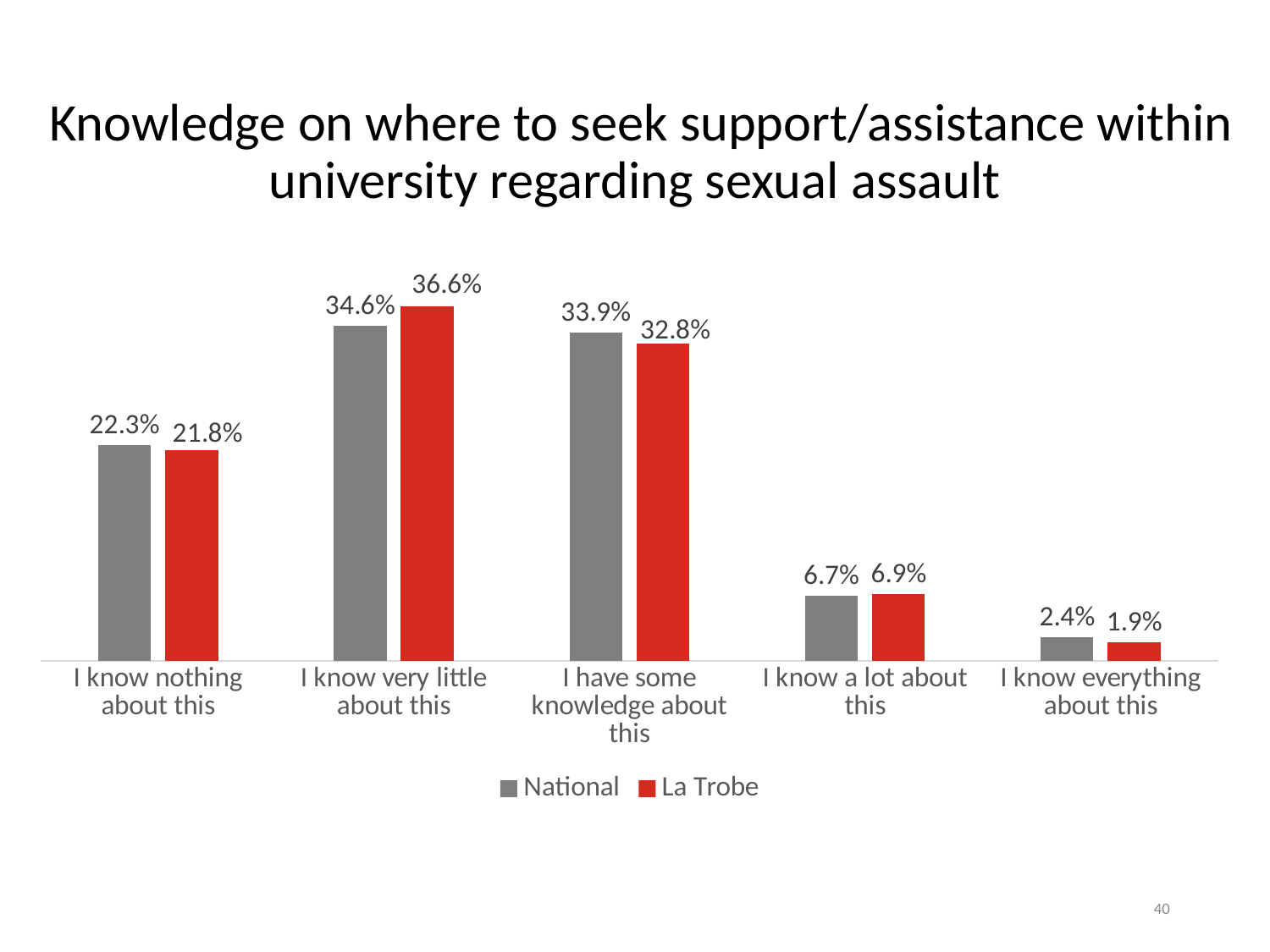
What is the National value for "I know nothing about this"? 22.3% What is the difference between the La Trobe and National values for "I know very little about this"? 2.0% Which category has the highest La Trobe value? I know very little about this How many categories are shown on the x axis? 5 Which category has the lowest National value? I know everything about this What is the La Trobe value for "I know everything about this"? 1.9% For "I have some knowledge about this", which is larger, the National or La Trobe value? National What is the La Trobe value for "I know very little about this"? 36.6% Which colour represents the La Trobe series in the legend? Red How many series does the legend list? 2 What kind of chart is shown on the slide? Bar chart What is the difference between the National and La Trobe values for "I know nothing about this"? 0.5%